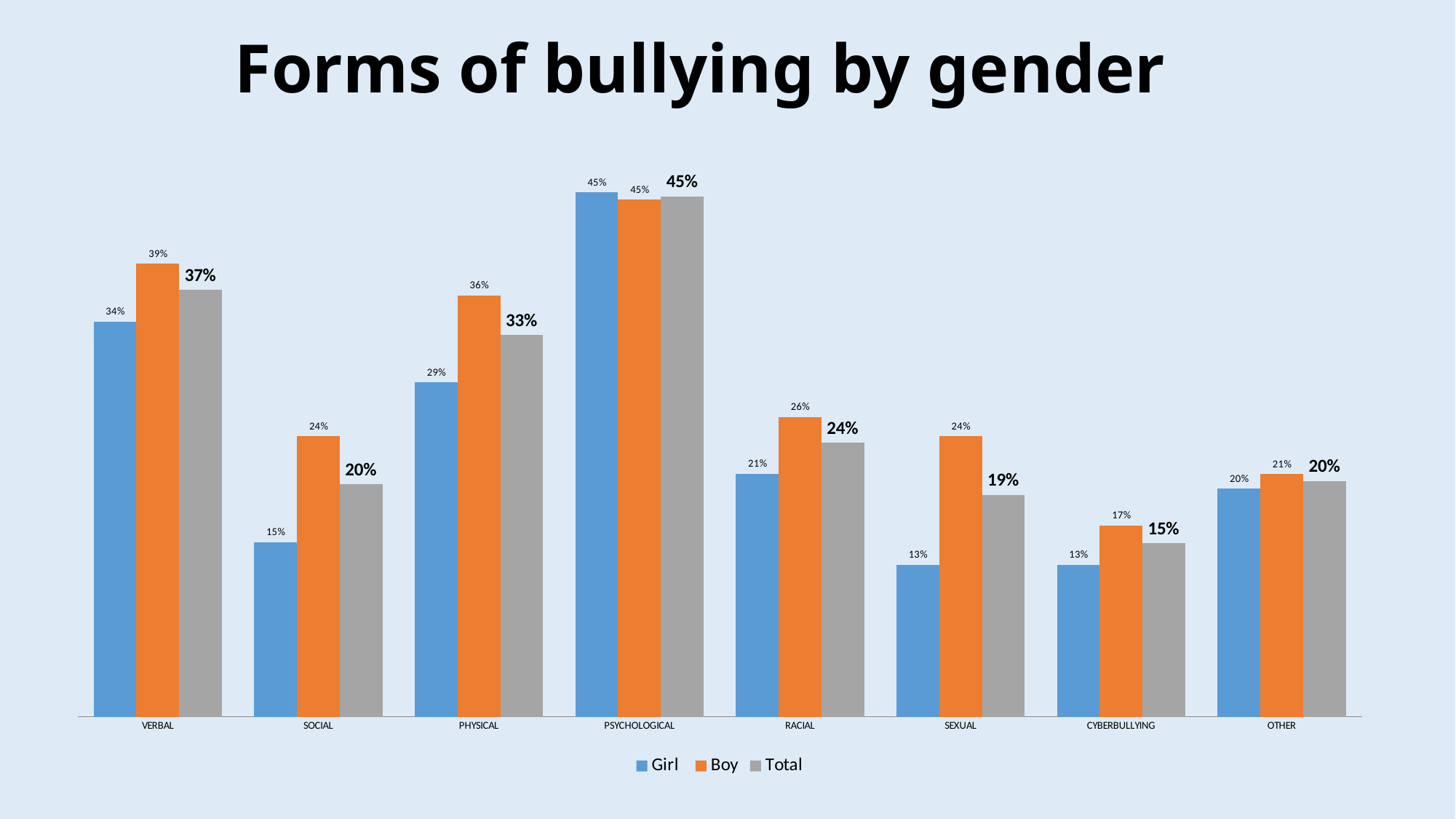
Which is larger for Racial bullying, the Girl value or the Boy value? Boy What is the difference between the Boy and Girl values for Sexual bullying? 11% Which form of bullying has the lowest Total value? Cyberbullying What kind of chart is shown on the slide? Bar chart What is the Girl value for Verbal bullying? 34% What is the Total value for Physical bullying? 33% Which form of bullying has the highest Total value? Psychological How many forms of bullying are shown on the x axis? 8 What is the Boy value for Social bullying? 24% How many series does the legend list? 3 What is the Boy value for Cyberbullying? 17% What is the title of the chart? Forms of bullying by gender